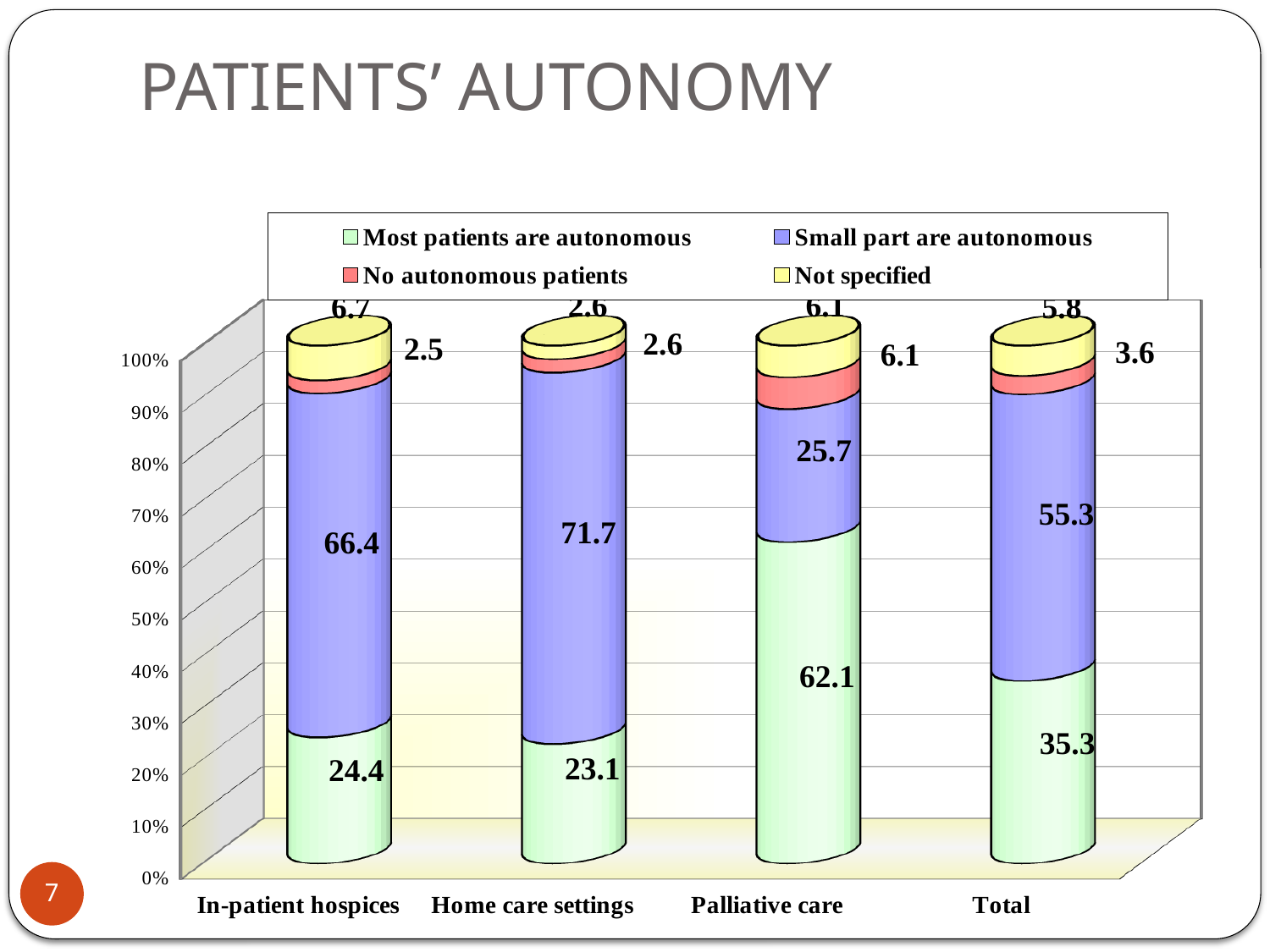
How many series does the legend list? 4 What is the value for 'Most patients are autonomous' in Palliative care? 62.1 What is the value for 'No autonomous patients' in the Total category? 3.6 What is the value for 'Small part are autonomous' in Home care settings? 71.7 Which category has the highest value for 'Most patients are autonomous'? Palliative care How many categories are shown on the x axis? 4 Which is larger: the 'Most patients are autonomous' value for In-patient hospices or for Home care settings? In-patient hospices What is the title of the slide containing the chart? PATIENTS' AUTONOMY What is the difference between the 'Small part are autonomous' values for Home care settings and In-patient hospices? 5.3 What is the difference between the 'Most patients are autonomous' values for Palliative care and Total? 26.8 What kind of chart is shown on the slide? Stacked bar chart Which category has the lowest value for 'Small part are autonomous'? Palliative care